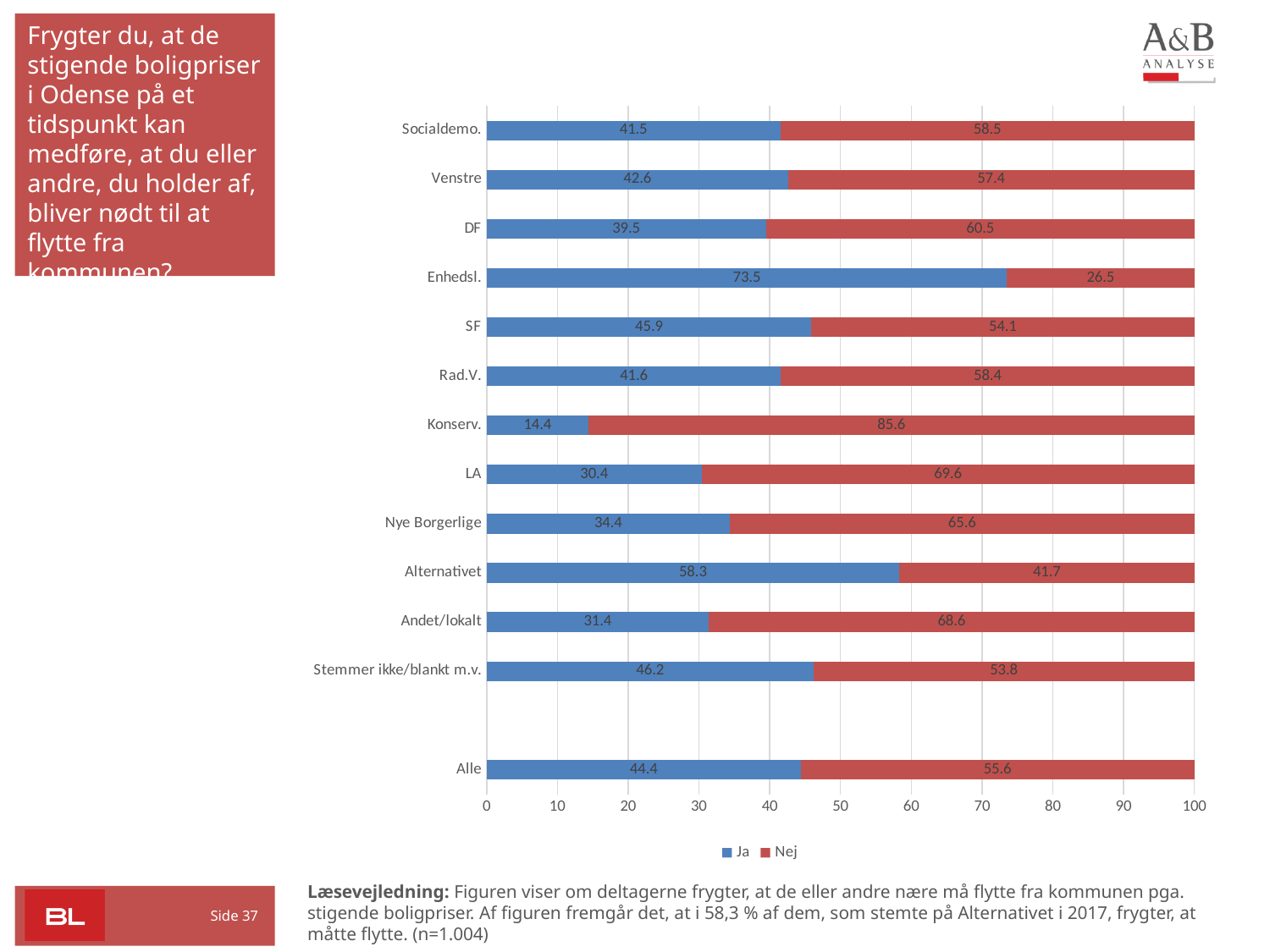
What is the "Ja" value for Alle? 44.4 Which category has the lowest "Ja" value? Konserv. What is the "Ja" value for Enhedsl.? 73.5 Which category has the highest "Ja" value? Enhedsl. What is the difference between the "Nej" value for Konserv. and the "Nej" value for Enhedsl.? 59.1 Which colour represents the "Nej" series in the chart? Red How many categories are shown on the y axis of the chart? 13 How many series does the legend list? 2 What is the total of the stacked bar for SF? 100 What is the "Nej" value for Konserv.? 85.6 Which is larger: the "Ja" value for Alternativet or the "Ja" value for LA? Alternativet What kind of chart is shown on the slide? Stacked bar chart